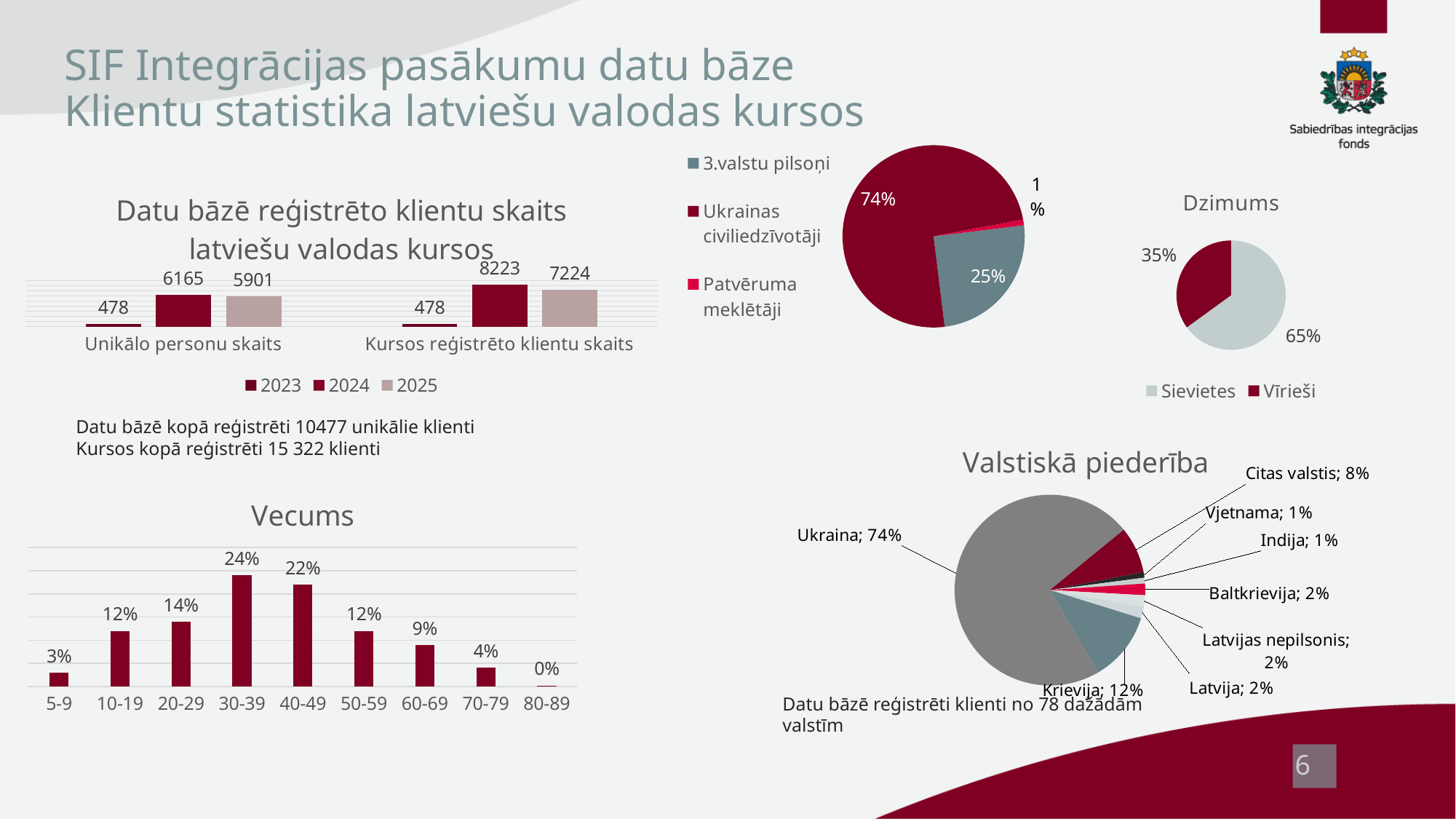
In the 'Valstiskā piederība' pie chart, which is larger: 'Citas valstis' or 'Baltkrievija'? Citas valstis In the pie chart at the top middle of the slide, what share is '3.valstu pilsoņi'? 25% In the 'Dzimums' pie chart, what share is 'Sievietes'? 65% What kind of chart is the 'Vecums' chart? bar chart In the chart 'Datu bāzē reģistrēto klientu skaits latviešu valodas kursos', what is the value for 2024 in the 'Unikālo personu skaits' group? 6165 In the 'Vecums' chart, which age group has the highest value? 30-39 In the chart 'Datu bāzē reģistrēto klientu skaits latviešu valodas kursos', what is the difference between the 2024 and 2025 values in the 'Kursos reģistrēto klientu skaits' group? 999 In the 'Vecums' chart, what is the value for the 60-69 age group? 9% How many age groups are shown in the 'Vecums' chart? 9 In the 'Valstiskā piederība' pie chart, what share is 'Krievija'? 12% How many series does the legend of the chart 'Datu bāzē reģistrēto klientu skaits latviešu valodas kursos' list? 3 In the chart 'Datu bāzē reģistrēto klientu skaits latviešu valodas kursos', what is the value for 2025 in the 'Kursos reģistrēto klientu skaits' group? 7224